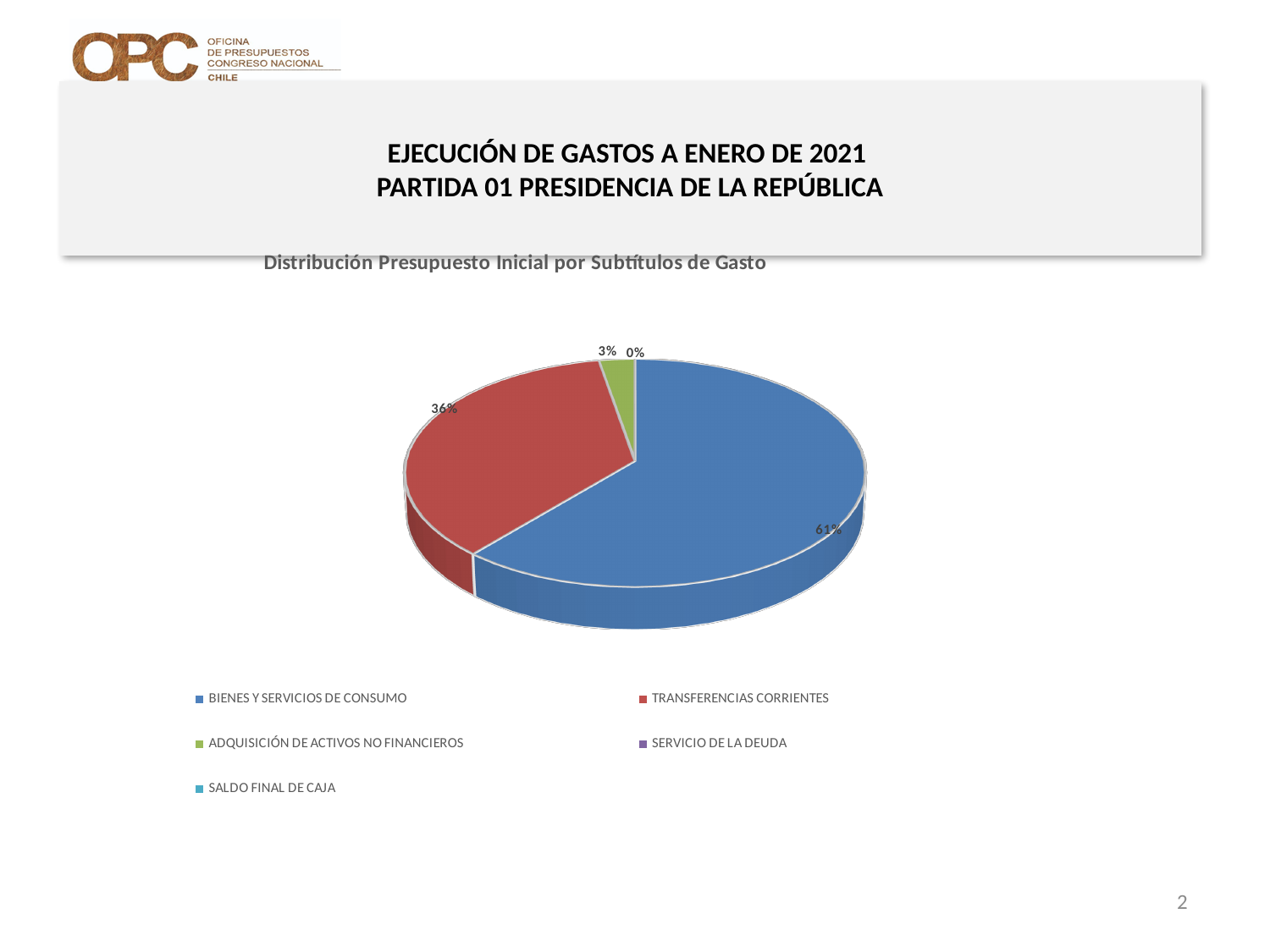
What colour is the slice for TRANSFERENCIAS CORRIENTES? Red Which slice is larger, TRANSFERENCIAS CORRIENTES or ADQUISICIÓN DE ACTIVOS NO FINANCIEROS? TRANSFERENCIAS CORRIENTES What share of the pie does TRANSFERENCIAS CORRIENTES represent? 36% What kind of chart is shown on the slide? Pie chart Is the share for BIENES Y SERVICIOS DE CONSUMO greater or less than 50%? greater What is the difference in percentage points between the BIENES Y SERVICIOS DE CONSUMO slice and the TRANSFERENCIAS CORRIENTES slice? 25 percentage points How many categories does the legend of the pie chart list? 5 Which category has the largest slice of the pie? BIENES Y SERVICIOS DE CONSUMO What is the title of the pie chart? Distribución Presupuesto Inicial por Subtítulos de Gasto What share of the pie does BIENES Y SERVICIOS DE CONSUMO represent? 61% What share of the pie does ADQUISICIÓN DE ACTIVOS NO FINANCIEROS represent? 3%